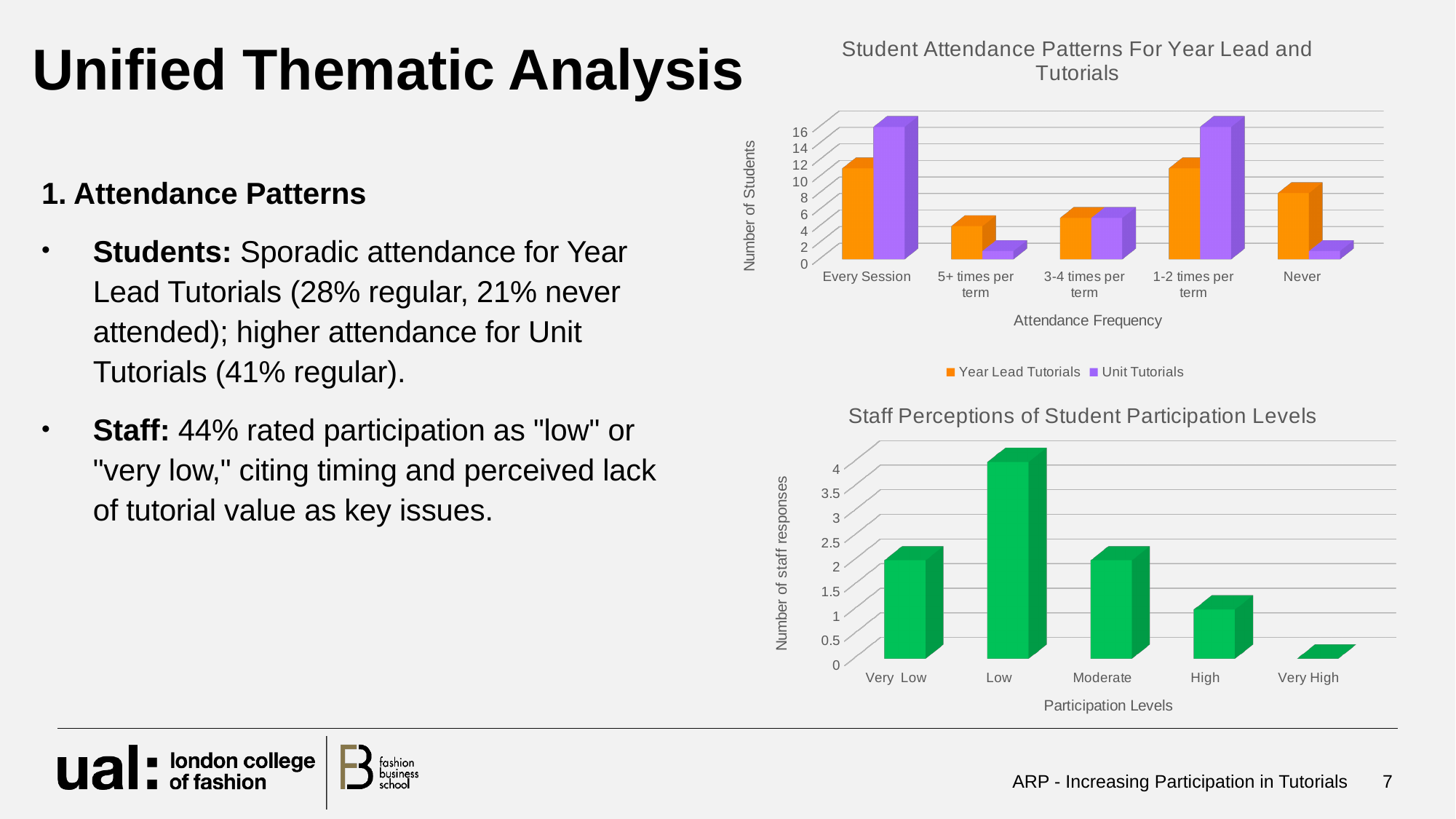
In the 'Staff Perceptions of Student Participation Levels' chart, which participation level received the fewest staff responses? Very High How many attendance frequency categories are shown on the 'Student Attendance Patterns For Year Lead and Tutorials' chart? 5 How many series does the legend of the 'Student Attendance Patterns For Year Lead and Tutorials' chart list? 2 What are the two series named in the legend of the 'Student Attendance Patterns For Year Lead and Tutorials' chart? Year Lead Tutorials and Unit Tutorials In the 'Student Attendance Patterns For Year Lead and Tutorials' chart, which series has the larger value for Never, Year Lead Tutorials or Unit Tutorials? Year Lead Tutorials In the 'Staff Perceptions of Student Participation Levels' chart, is the value for Low greater or less than 3? greater What kind of chart is the 'Student Attendance Patterns For Year Lead and Tutorials' chart? Bar chart How many participation level categories are shown on the 'Staff Perceptions of Student Participation Levels' chart? 5 In the 'Student Attendance Patterns For Year Lead and Tutorials' chart, is the Unit Tutorials value for Never greater or less than 4? less In the 'Student Attendance Patterns For Year Lead and Tutorials' chart, which series has the larger value for Every Session, Year Lead Tutorials or Unit Tutorials? Unit Tutorials In the 'Staff Perceptions of Student Participation Levels' chart, which participation level received the most staff responses? Low In the 'Student Attendance Patterns For Year Lead and Tutorials' chart, is the Unit Tutorials value for Every Session greater or less than 14? greater